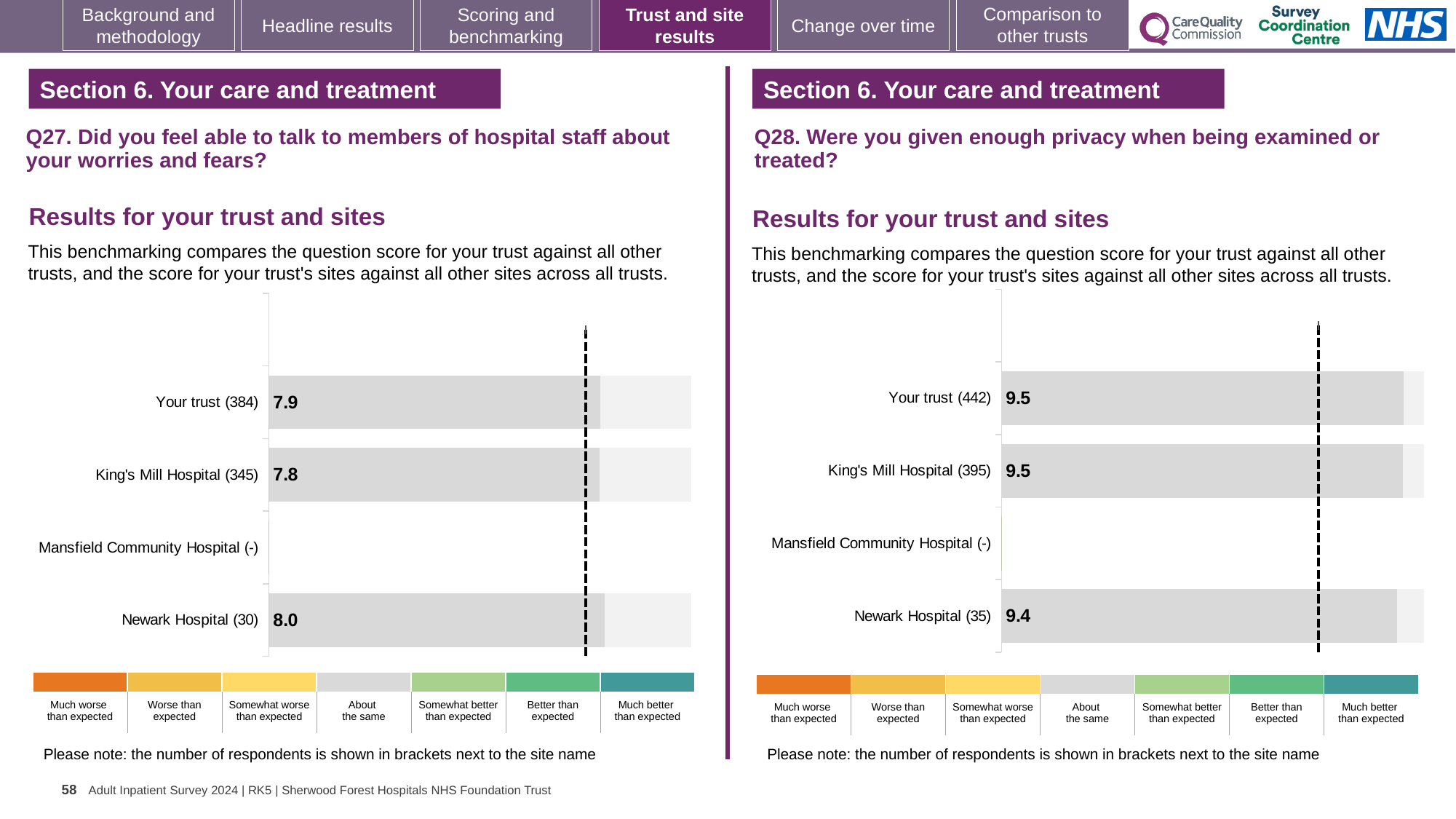
What kind of chart is used for the Q28 results on the right? Bar chart In the Q27 chart on the left, what is the score for Your trust? 7.9 In the Q27 chart on the left, which site or trust has the lowest score among those with a value shown? King's Mill Hospital In the Q27 chart on the left, which has a higher score: Newark Hospital or King's Mill Hospital? Newark Hospital In the Q27 chart on the left, which site or trust has the highest score? Newark Hospital In the Q28 chart on the right, what is the score for Newark Hospital? 9.4 In the Q28 chart on the right, what is the score for Your trust? 9.5 In the Q27 chart on the left, what is the score for King's Mill Hospital? 7.8 How many categories (trust and sites) are listed on the y axis of the Q27 chart on the left? 4 In the Q27 chart on the left, what is the score for Newark Hospital? 8.0 In the Q28 chart on the right, what is the difference between the score for Your trust and the score for Newark Hospital? 0.1 How many respondents are shown in brackets for Your trust in the Q28 chart on the right? 442